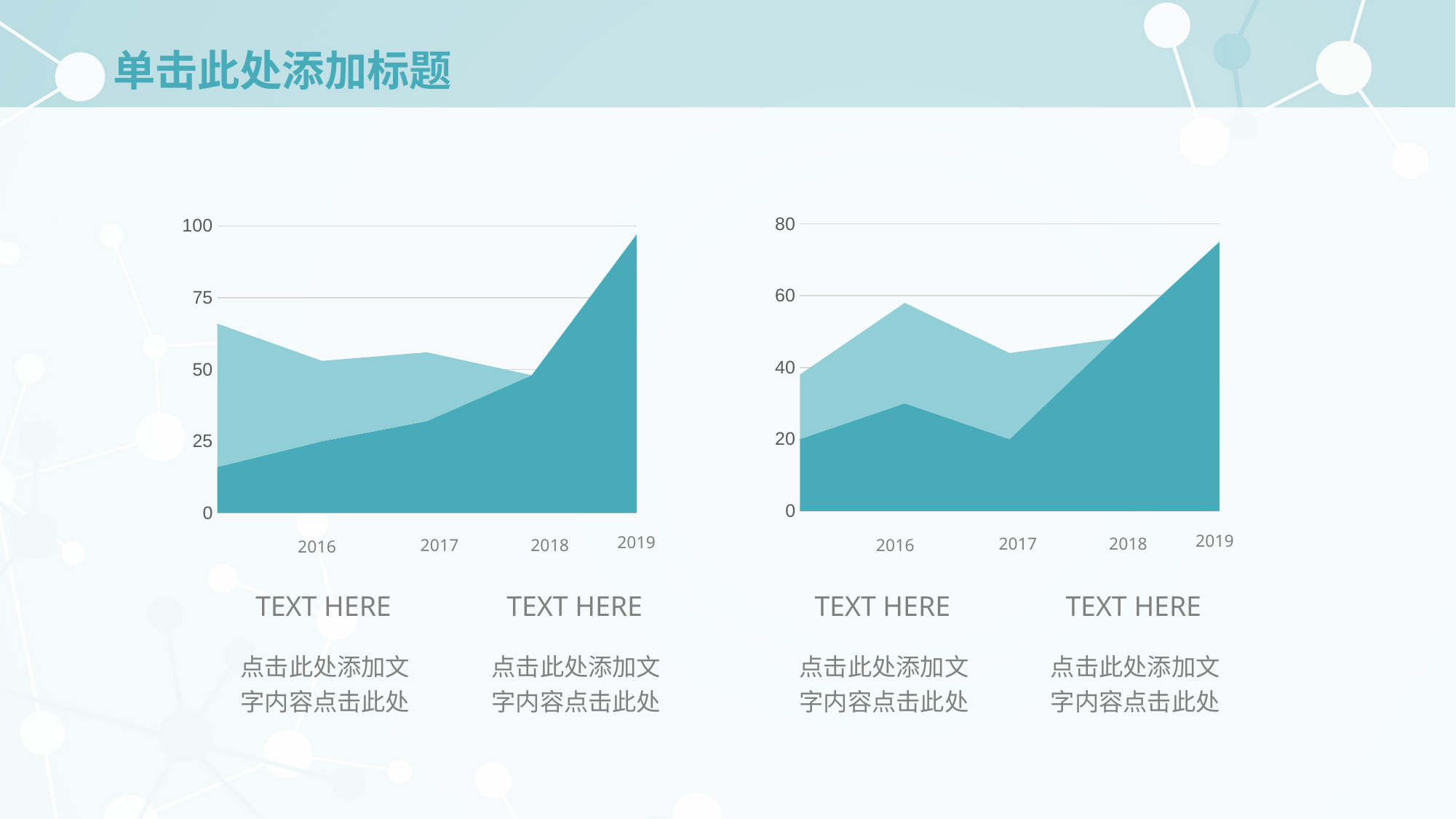
How many shaded series are plotted in the left chart? 2 How many year labels are shown on the x axis of the right chart? 4 What is the highest value shown on the y axis of the right chart? 80 In the left chart, is the value of the darker series for 2019 greater or less than 75? greater In the right chart, is the value of the darker series for 2019 greater or less than 60? greater In the right chart, is the value of the darker series for 2016 greater or less than 20? greater In the right chart, is the darker series larger in 2018 or in 2017? 2018 In the right chart, in which labelled year does the darker series reach its lowest value? 2017 In the left chart, does the darker series rise or fall from 2016 to 2019? rise What kind of chart is the left chart on the slide? area chart In the left chart, in which labelled year does the darker series reach its highest value? 2019